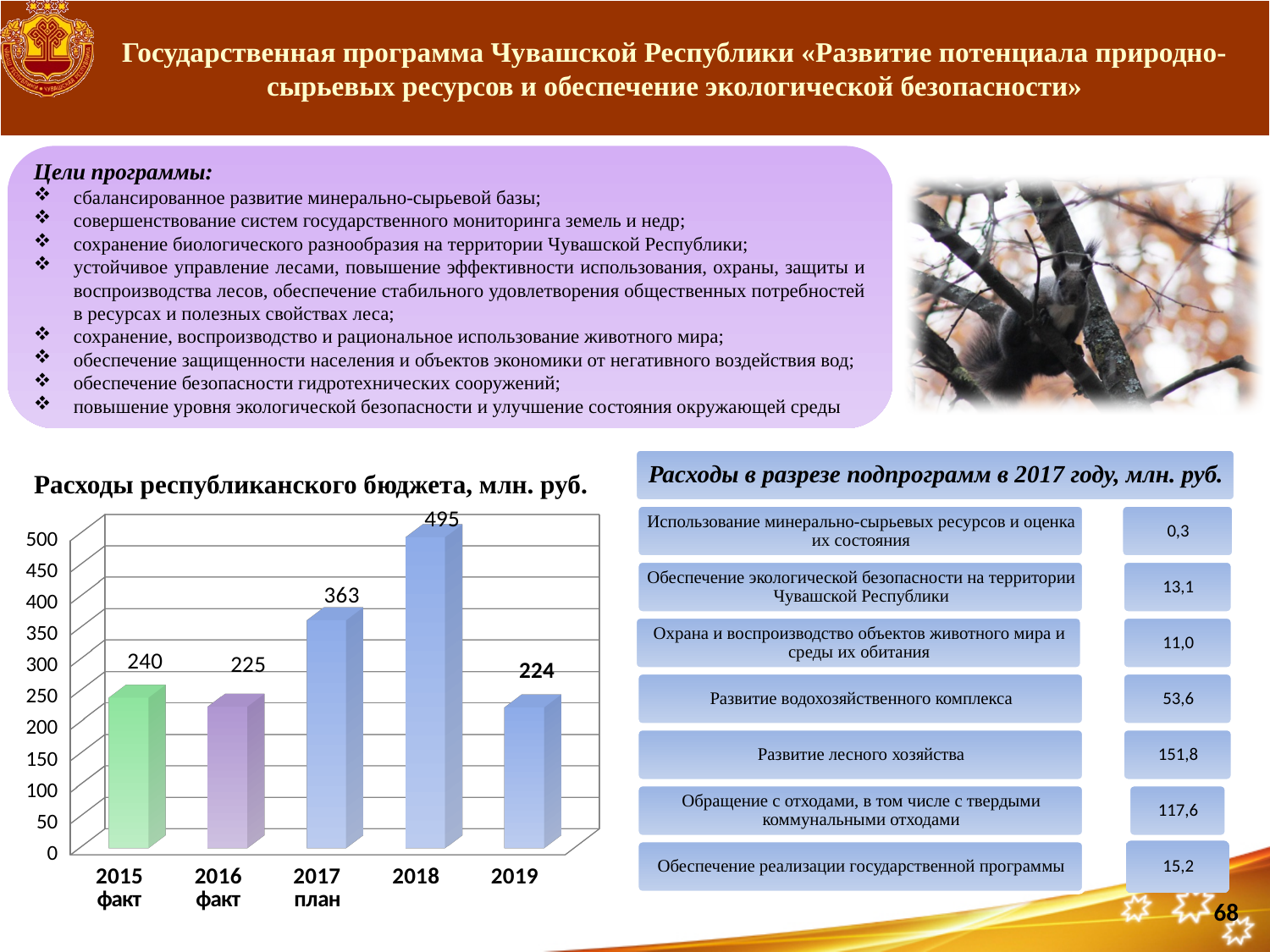
In the chart 'Расходы республиканского бюджета, млн. руб.', what is the difference between the values for 2015 факт and 2016 факт? 15 In the chart 'Расходы республиканского бюджета, млн. руб.', which is larger, the value for 2017 план or the value for 2019? 2017 план In the chart 'Расходы республиканского бюджета, млн. руб.', what is the value for 2015 факт? 240 In the chart 'Расходы республиканского бюджета, млн. руб.', do the values rise or fall from 2016 факт to 2018? rise In the chart 'Расходы республиканского бюджета, млн. руб.', is the value for 2018 greater or less than 450? greater What type of chart is 'Расходы республиканского бюджета, млн. руб.'? bar chart In the chart 'Расходы республиканского бюджета, млн. руб.', what is the value for 2017 план? 363 In the chart 'Расходы республиканского бюджета, млн. руб.', which year has the lowest value? 2019 In the chart 'Расходы республиканского бюджета, млн. руб.', what is the value for 2019? 224 In the chart 'Расходы республиканского бюджета, млн. руб.', which year has the highest value? 2018 In the chart 'Расходы республиканского бюджета, млн. руб.', what is the difference between the values for 2018 and 2017 план? 132 How many bars are shown in the chart 'Расходы республиканского бюджета, млн. руб.'? 5